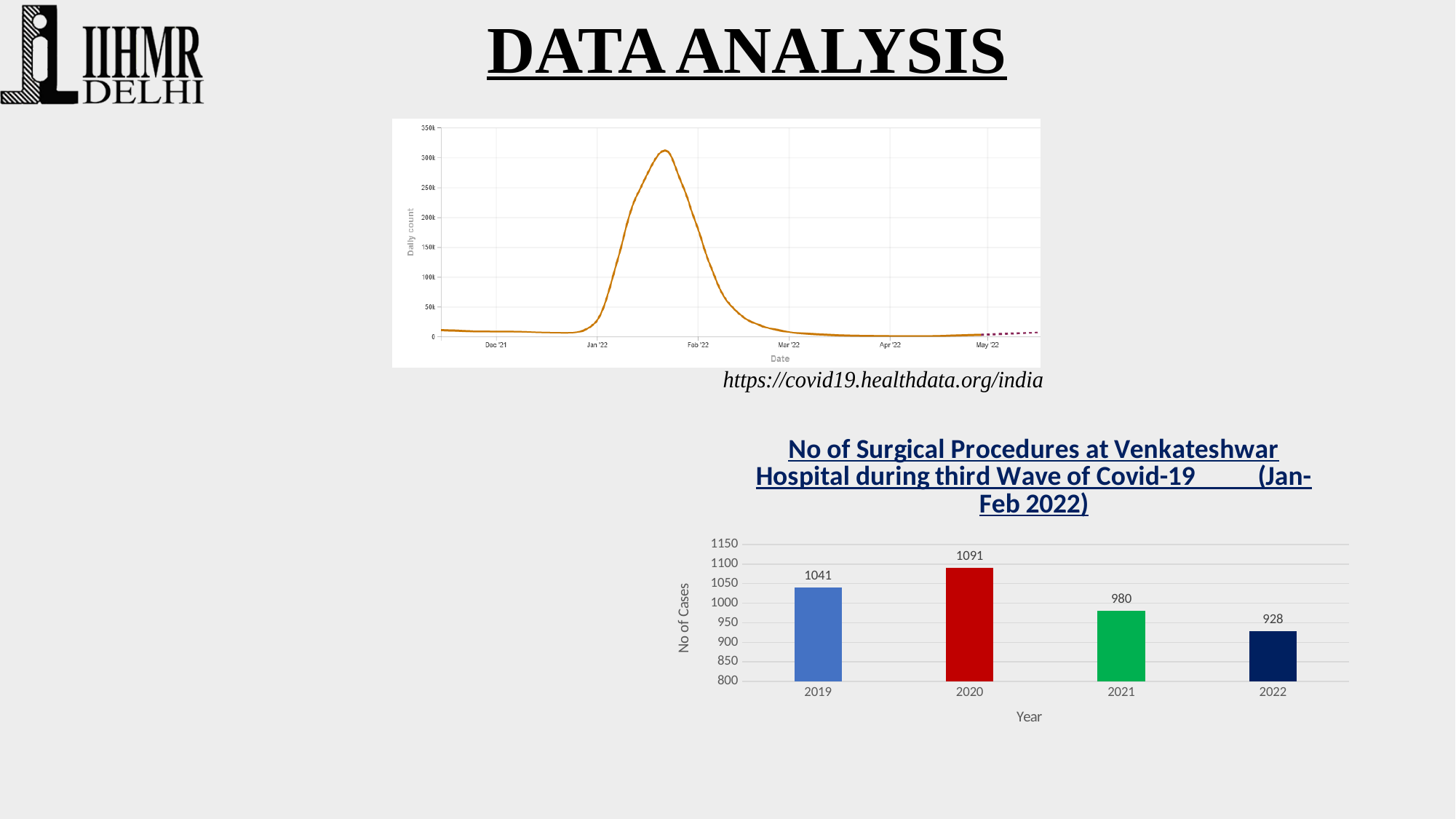
In the bar chart 'No of Surgical Procedures at Venkateshwar Hospital', what is the value for 2022? 928 In the bar chart 'No of Surgical Procedures at Venkateshwar Hospital', do the values rise or fall from 2020 to 2022? fall In the bar chart 'No of Surgical Procedures at Venkateshwar Hospital', what is the difference between the values for 2021 and 2022? 52 What is the y-axis label of the bar chart 'No of Surgical Procedures at Venkateshwar Hospital'? No of Cases What kind of chart is the top chart on the slide showing daily count by date? line chart How many years are shown in the bar chart 'No of Surgical Procedures at Venkateshwar Hospital'? 4 In the bar chart 'No of Surgical Procedures at Venkateshwar Hospital', what is the value for 2020? 1091 In the bar chart 'No of Surgical Procedures at Venkateshwar Hospital', which year has the lowest number of cases? 2022 In the top line chart of daily count, is the peak value greater or less than 250k? greater In the bar chart 'No of Surgical Procedures at Venkateshwar Hospital', which is larger, the value for 2019 or the value for 2021? 2019 In the bar chart 'No of Surgical Procedures at Venkateshwar Hospital', which year has the highest number of cases? 2020 In the bar chart 'No of Surgical Procedures at Venkateshwar Hospital', what is the difference between the values for 2020 and 2019? 50